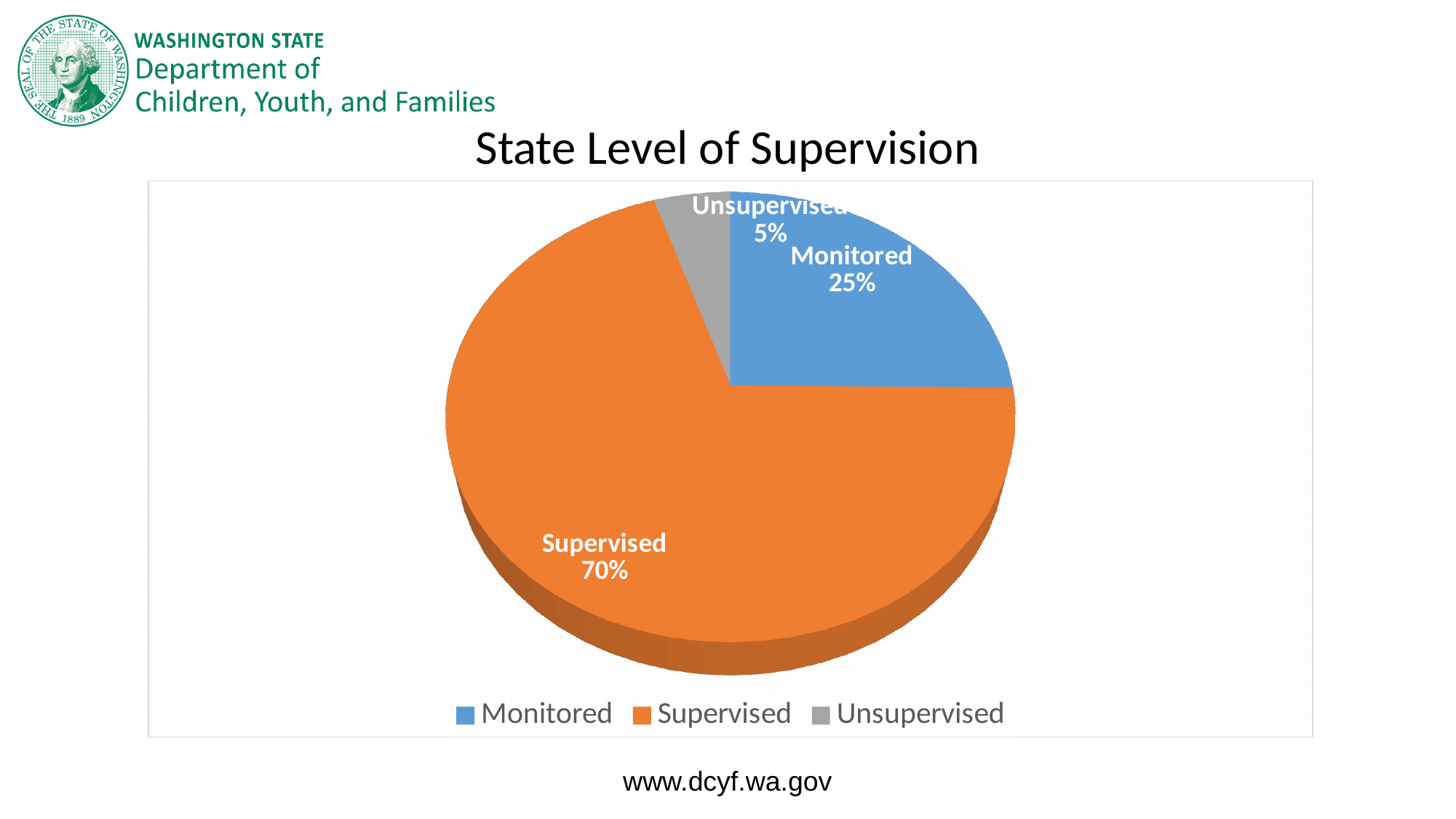
How many categories does the pie chart show? 3 What is the difference between the Supervised and Monitored shares? 45% Which is larger, Monitored or Unsupervised? Monitored How many entries does the legend list? 3 What share of the pie is Supervised? 70% What is the title of the chart? State Level of Supervision What kind of chart is shown on the slide? pie chart Which category has the largest slice? Supervised What colour is the Supervised slice? orange Which category has the smallest slice? Unsupervised What share of the pie is Monitored? 25% What share of the pie is Unsupervised? 5%